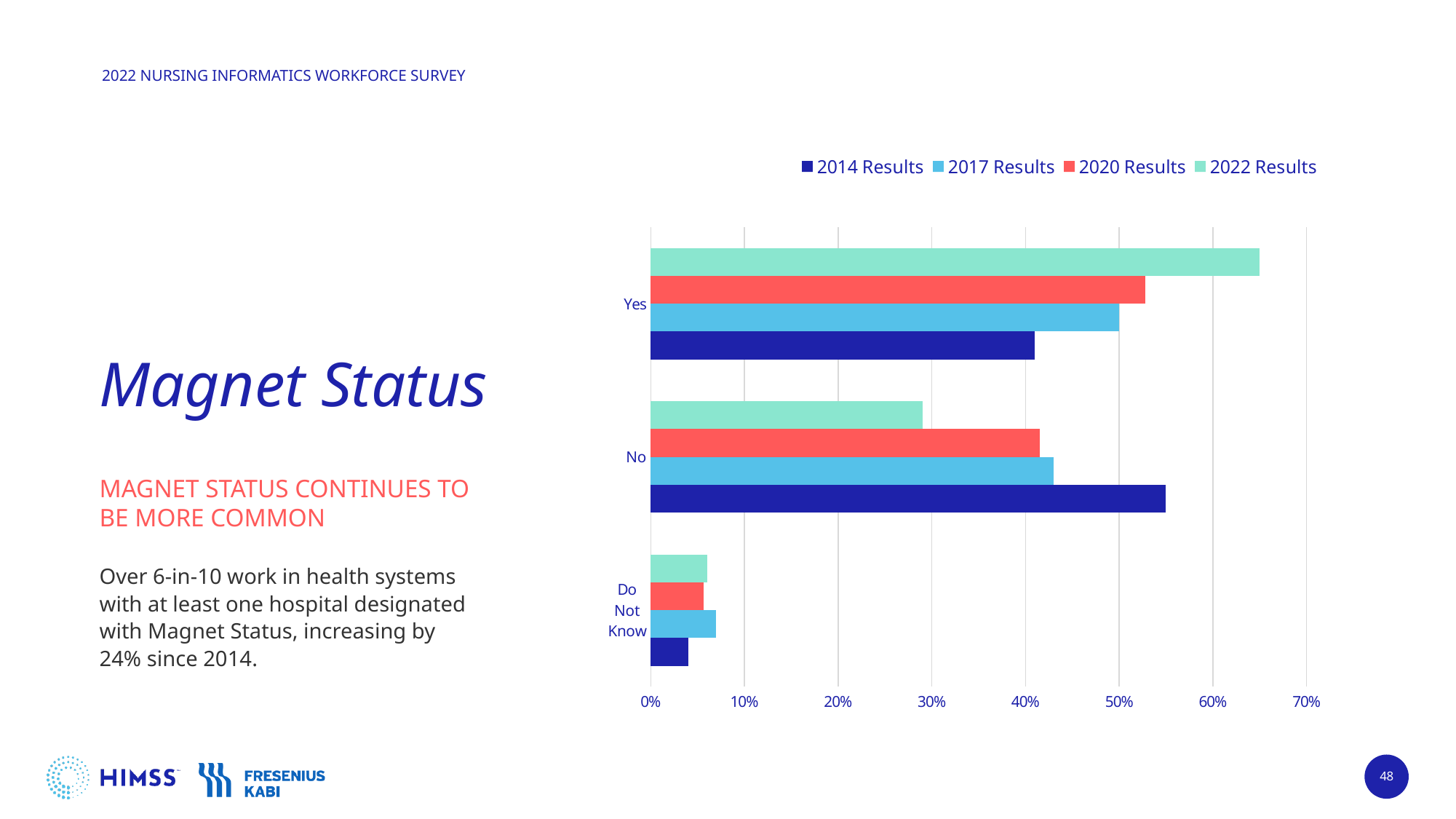
How many response categories are shown on the chart? 3 What kind of chart is shown on the slide? Bar chart For the "Yes" category, do the values rise or fall from 2014 Results to 2022 Results? rise For the "No" category, which is larger: the 2014 Results value or the 2022 Results value? 2014 Results For the "Yes" category, which survey year has the highest value? 2022 Results Is the 2022 Results value for "Yes" greater or less than 60%? greater Is the 2022 Results value for "No" greater or less than 40%? less Which response category has the lowest value for 2014 Results? Do Not Know For the "No" category, which survey year has the highest value? 2014 Results How many series does the legend list? 4 Is the 2014 Results value for "Yes" greater or less than 50%? less Which response category has the highest value for 2022 Results? Yes